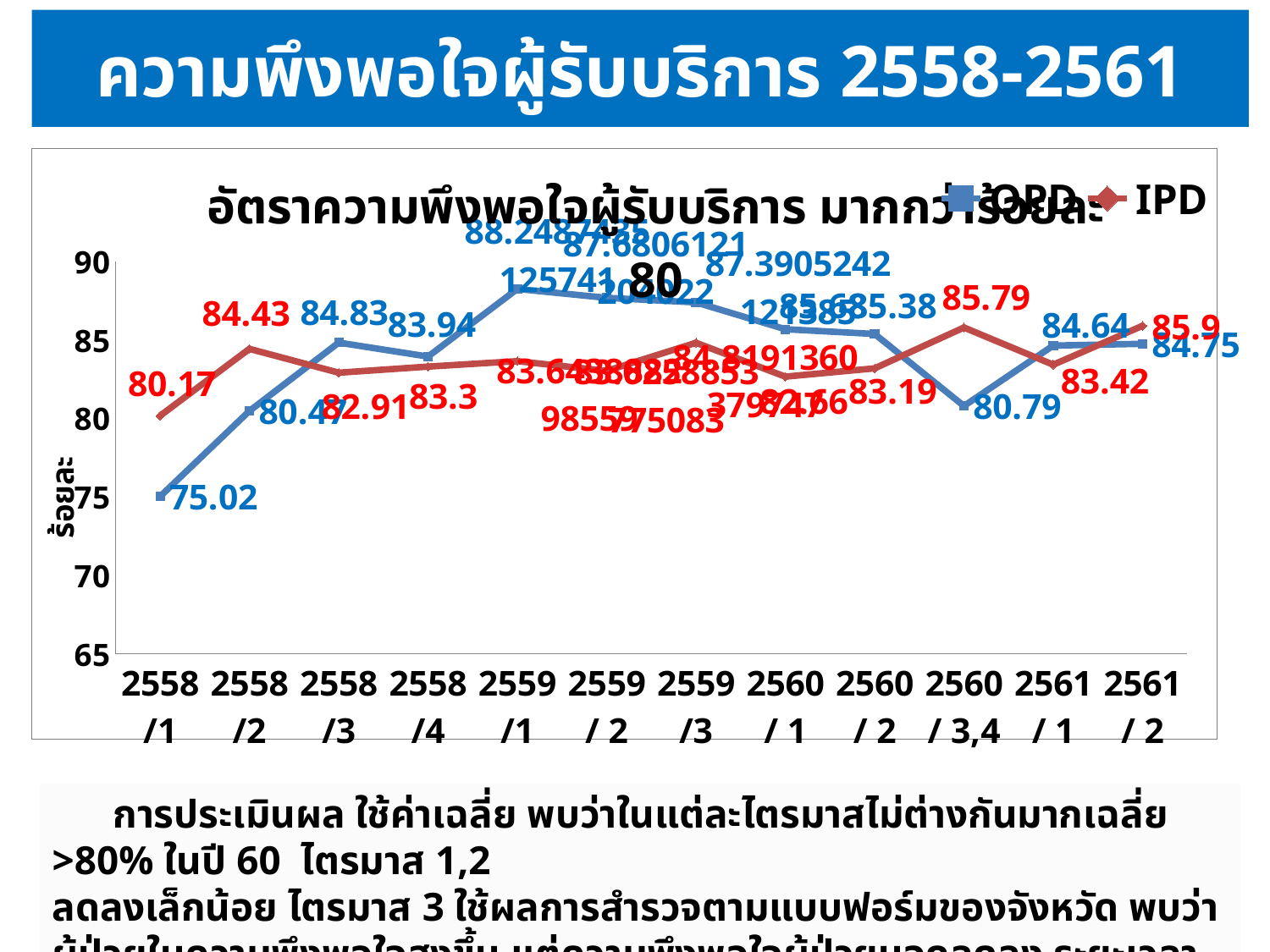
What is the IPD value for 2558/1? 80.17 How many series does the legend list? 2 What is the OPD value for 2561/2? 84.75 What is the OPD value for 2558/1? 75.02 What is the IPD value for 2561/1? 83.42 What kind of chart is shown on the slide? line chart Is the OPD value for 2559/1 greater or less than 85? greater In which quarter is the OPD value lowest? 2558/1 How many quarter categories are shown along the x axis? 12 What is the IPD value for 2560/3,4? 85.79 For 2560/3,4, which series has the larger value, OPD or IPD? IPD